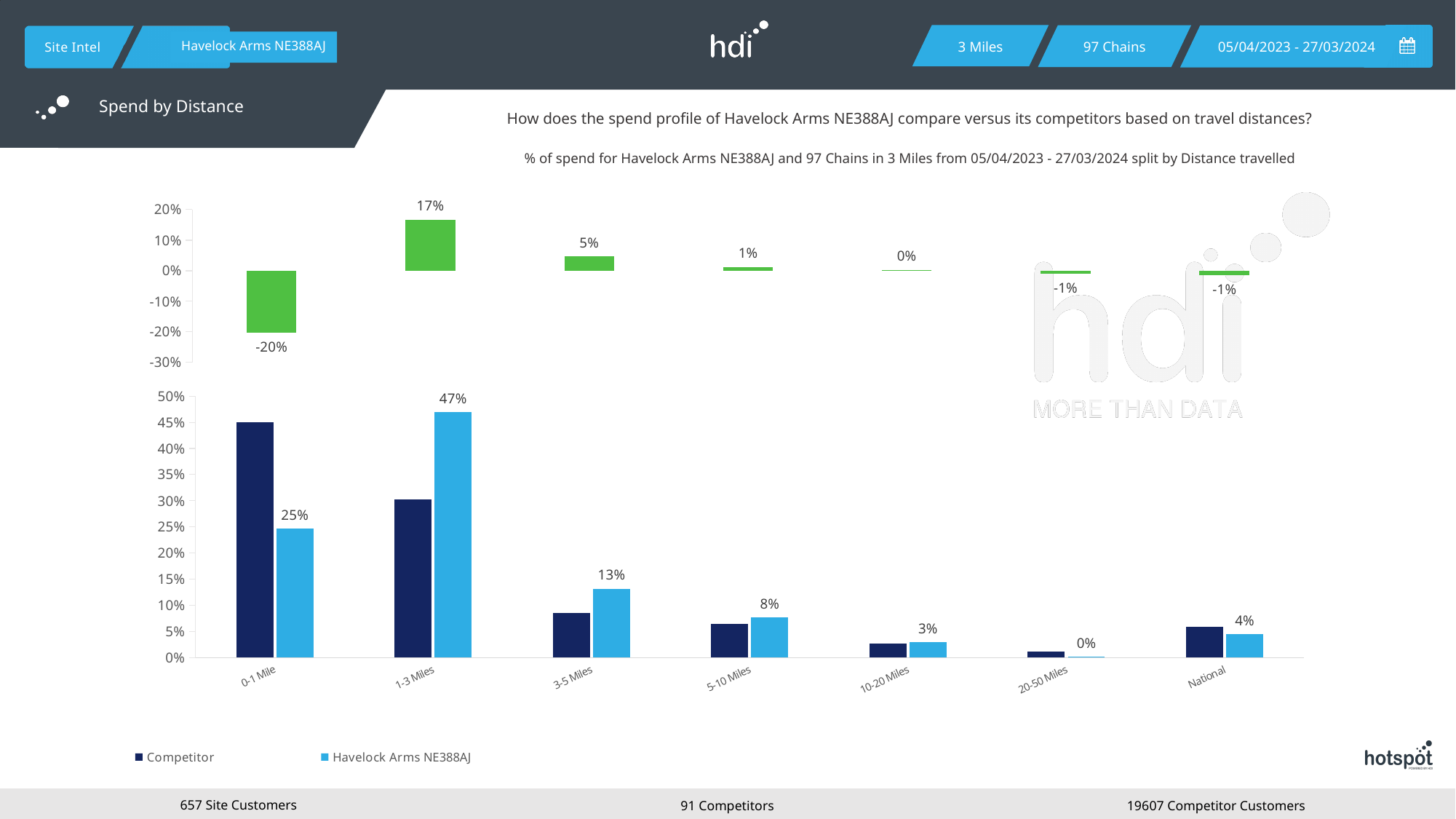
How many distance categories are shown on the x axis of the bottom chart? 7 What type of chart is the bottom chart? Bar chart In the bottom chart, what is the value for Havelock Arms NE388AJ in the 1-3 Miles category? 47% In the bottom chart, which is larger in the 0-1 Mile category: the Competitor bar or the Havelock Arms NE388AJ bar? Competitor In the bottom chart, is the Competitor value for 1-3 Miles greater or less than 35%? less In the top chart, which category has the highest value? 1-3 Miles In the bottom chart, which category has the lowest value for Havelock Arms NE388AJ? 20-50 Miles In the bottom chart, what is the value for Havelock Arms NE388AJ in the 0-1 Mile category? 25% In the top chart, what is the value shown for the 0-1 Mile category? -20% In the bottom chart, what is the difference between the Havelock Arms NE388AJ values for 1-3 Miles and 3-5 Miles? 34% In the bottom chart, is the Competitor value for 0-1 Mile greater or less than 40%? greater How many series does the legend of the bottom chart list? 2